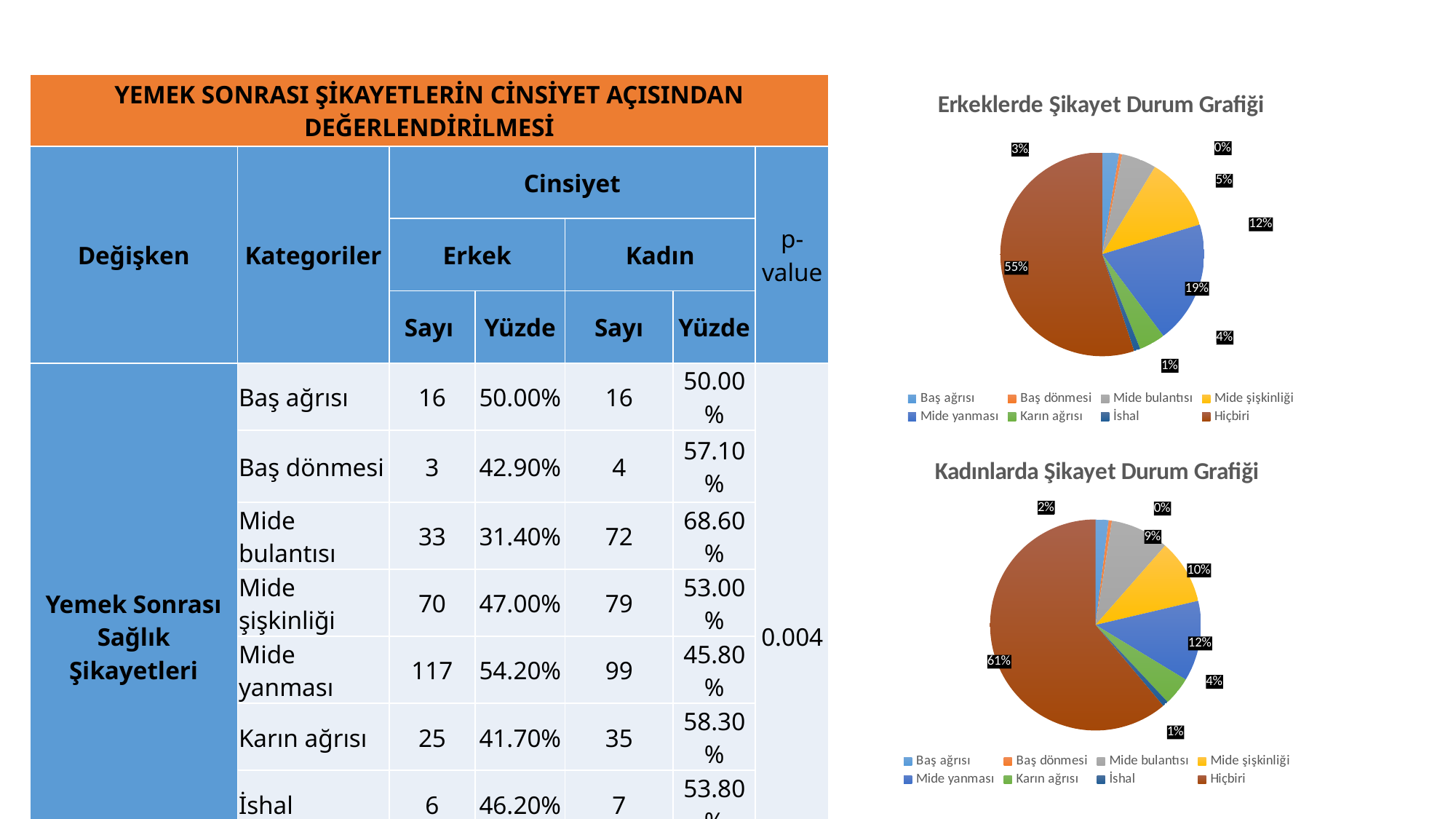
In the 'Erkeklerde Şikayet Durum Grafiği' pie chart, what is the difference between the Mide yanması share and the Mide şişkinliği share? 7% In the 'Kadınlarda Şikayet Durum Grafiği' pie chart, what is the share for Mide bulantısı? 9% In the 'Erkeklerde Şikayet Durum Grafiği' pie chart, what is the share for Mide yanması? 19% Which category has the largest slice in the 'Erkeklerde Şikayet Durum Grafiği' pie chart? Hiçbiri How many entries does the legend of the 'Kadınlarda Şikayet Durum Grafiği' pie chart list? 8 In the 'Kadınlarda Şikayet Durum Grafiği' pie chart, what is the share for Mide şişkinliği? 10% What type of chart is the 'Erkeklerde Şikayet Durum Grafiği'? pie chart In the 'Erkeklerde Şikayet Durum Grafiği' pie chart, what share does Hiçbiri have? 55% In the 'Kadınlarda Şikayet Durum Grafiği' pie chart, which is larger: the Mide yanması share or the Karın ağrısı share? Mide yanması What colour represents Hiçbiri in the legend of the 'Erkeklerde Şikayet Durum Grafiği' pie chart? brown In the 'Kadınlarda Şikayet Durum Grafiği' pie chart, what share does Hiçbiri have? 61% Which pie chart shows a larger share for Hiçbiri, 'Erkeklerde Şikayet Durum Grafiği' or 'Kadınlarda Şikayet Durum Grafiği'? Kadınlarda Şikayet Durum Grafiği